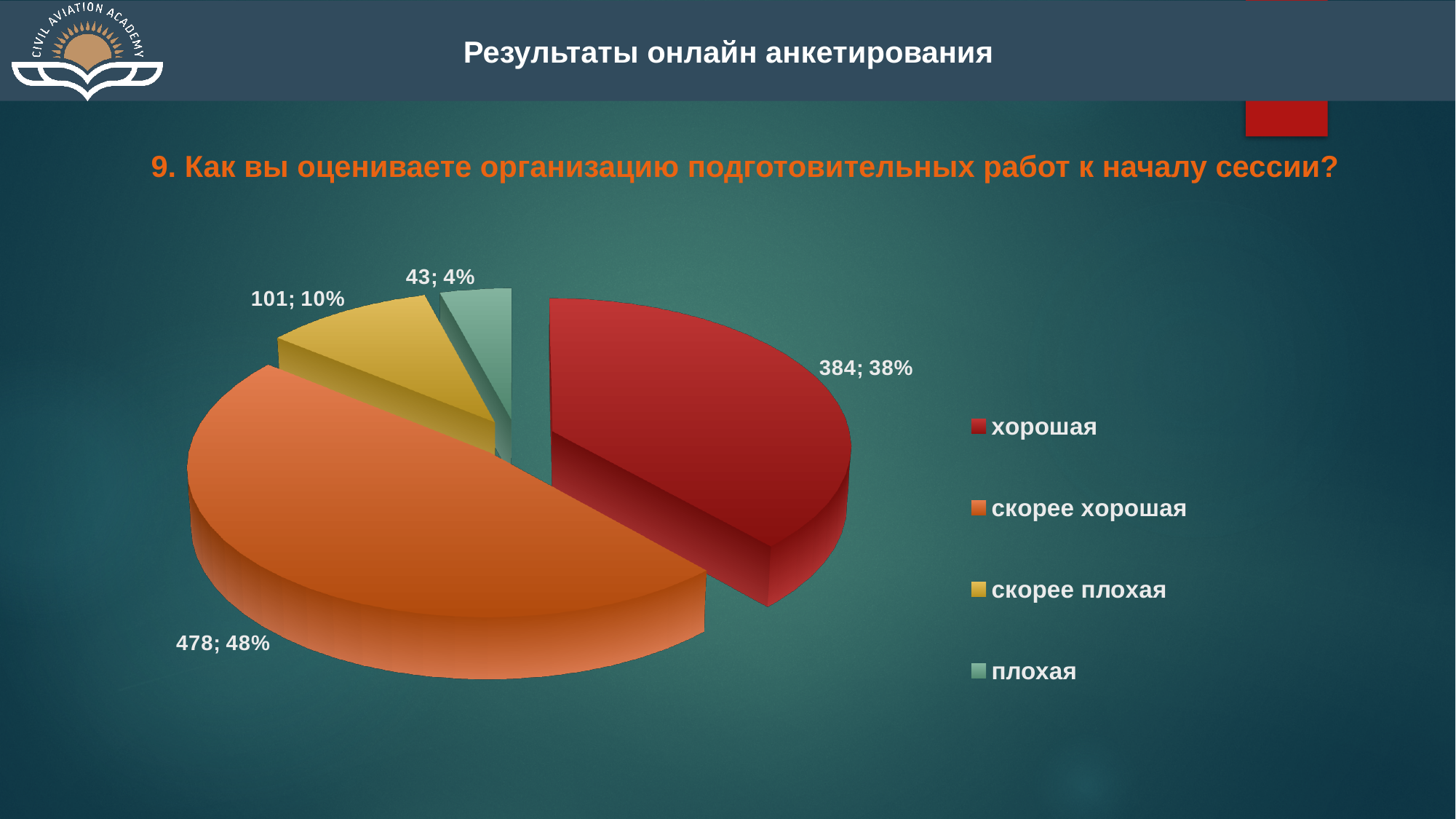
What share of the pie does the 'плохая' slice represent? 4% What share of the pie does the 'скорее хорошая' slice represent? 48% Which category has the largest slice? скорее хорошая What is the count for the 'скорее хорошая' slice? 478 What is the count for the 'хорошая' slice? 384 How many entries does the legend list? 4 Which category has the smallest slice? плохая What is the count for the 'скорее плохая' slice? 101 How many slices does the pie chart have? 4 What is the difference between the counts for 'скорее хорошая' and 'хорошая'? 94 What is the count for the 'плохая' slice? 43 What kind of chart is shown on the slide? Pie chart